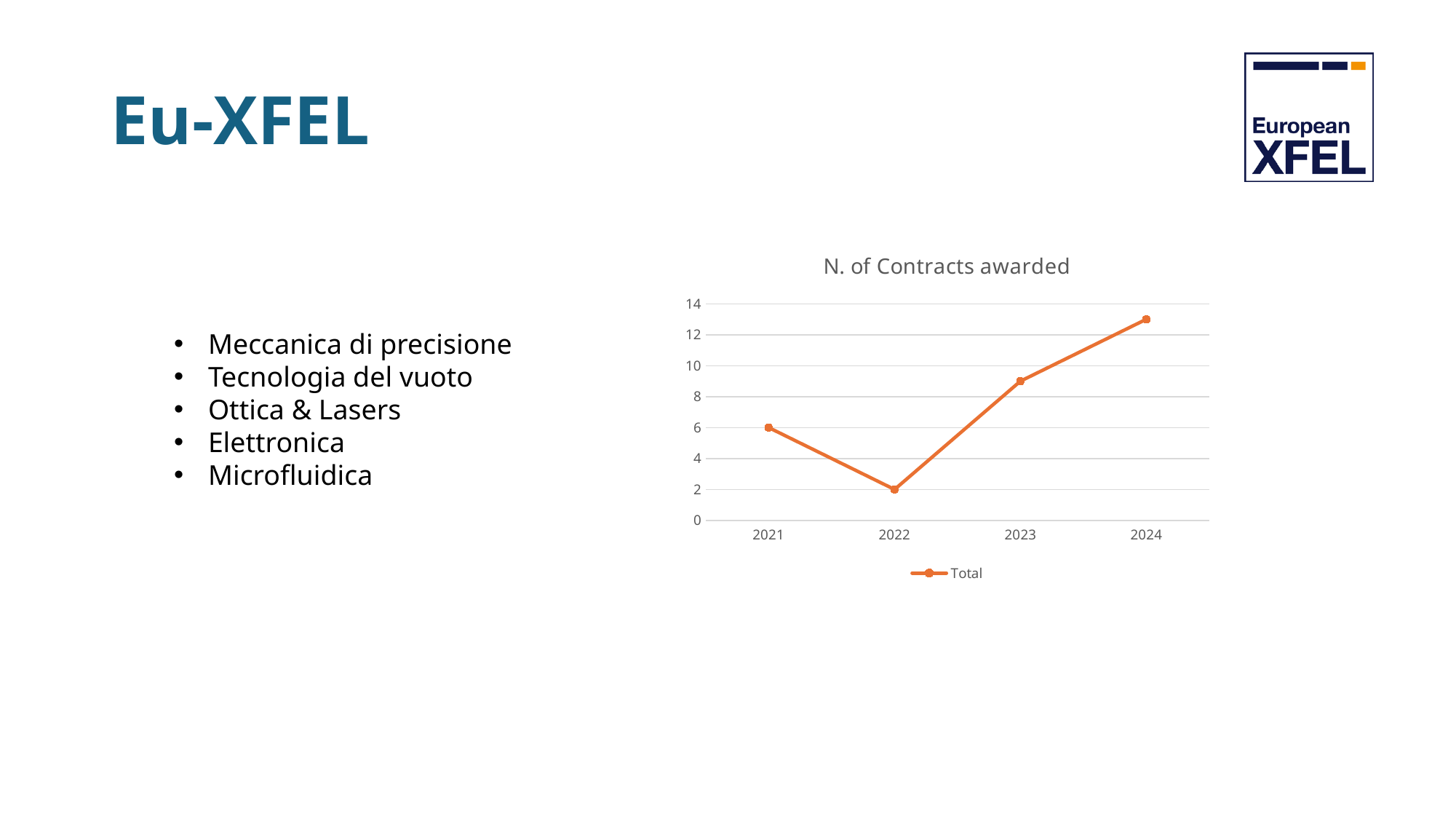
Is the value for 2023 greater or less than 8? greater What is the value for 2022? 2 How many series does the legend list? 1 Which year has the lowest number of contracts awarded? 2022 What is the value for 2021? 6 How many years are plotted on the x axis? 4 What is the name of the series shown in the legend? Total What type of chart is shown on the slide? line chart What is the title of the chart? N. of Contracts awarded Is the value for 2024 greater or less than 12? greater Which year has the highest number of contracts awarded? 2024 What is the difference between the values for 2021 and 2022? 4